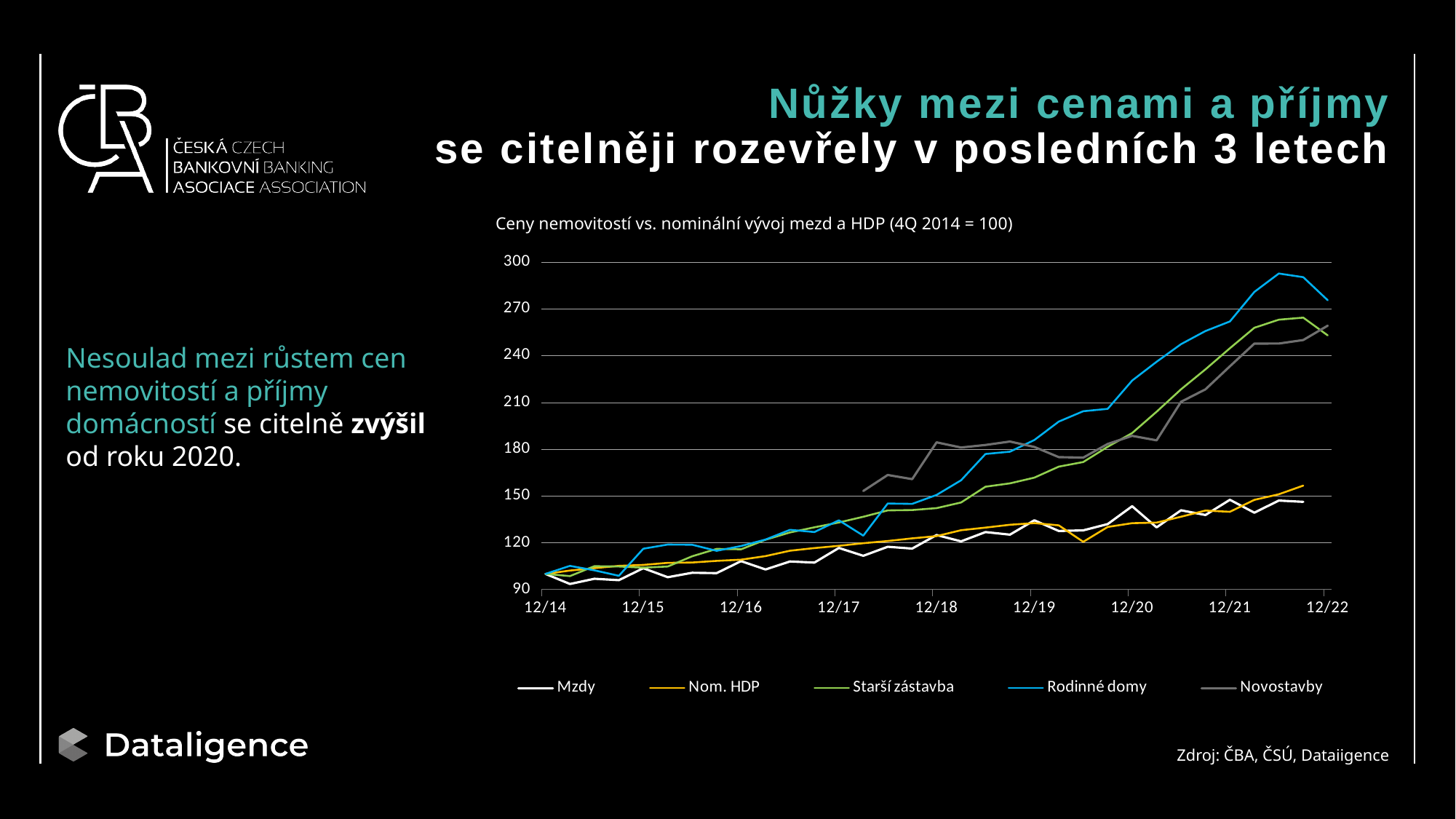
Which series has the highest value at 12/22? Rodinné domy What is the title of the chart? Ceny nemovitostí vs. nominální vývoj mezd a HDP (4Q 2014 = 100) Is the value for Rodinné domy at 12/22 greater or less than 240? greater What type of chart is shown on the slide? line chart At 12/20, which is larger: Rodinné domy or Starší zástavba? Rodinné domy At 12/17, which is larger: Rodinné domy or Mzdy? Rodinné domy Does the Rodinné domy series rise or fall overall from 12/14 to 12/22? rises Which series reaches the highest value anywhere on the chart? Rodinné domy Is the value for Novostavby at 12/19 greater or less than 150? greater How many series does the legend list? 5 How many year labels are shown on the x axis? 9